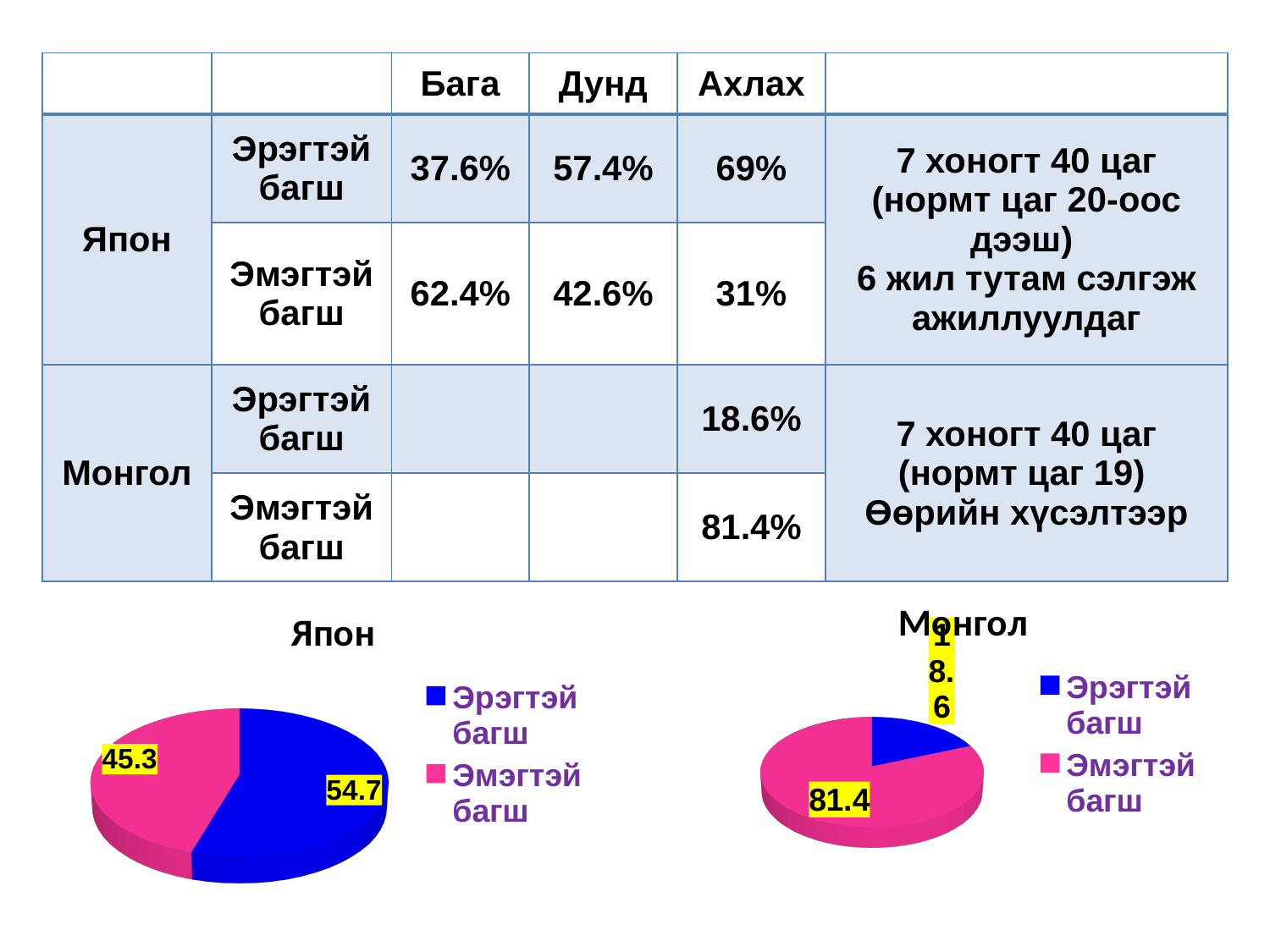
In the Япон chart, what is the value for Эмэгтэй багш? 45.3 In the Япон chart, what is the difference between the values for Эрэгтэй багш and Эмэгтэй багш? 9.4 In the Япон chart, what is the value for Эрэгтэй багш? 54.7 In the Япон chart, which category has the largest slice? Эрэгтэй багш In the Монгол chart, what is the value for Эмэгтэй багш? 81.4 In the Япон chart, which is larger: Эрэгтэй багш or Эмэгтэй багш? Эрэгтэй багш What kind of chart is the Монгол chart? Pie chart In the Монгол chart, what is the difference between the values for Эмэгтэй багш and Эрэгтэй багш? 62.8 In the Монгол chart, which category has the smallest slice? Эрэгтэй багш How many slices does the Япон chart have? 2 In the Монгол chart, what colour is the Эмэгтэй багш slice? Pink In the Монгол chart, what is the value for Эрэгтэй багш? 18.6